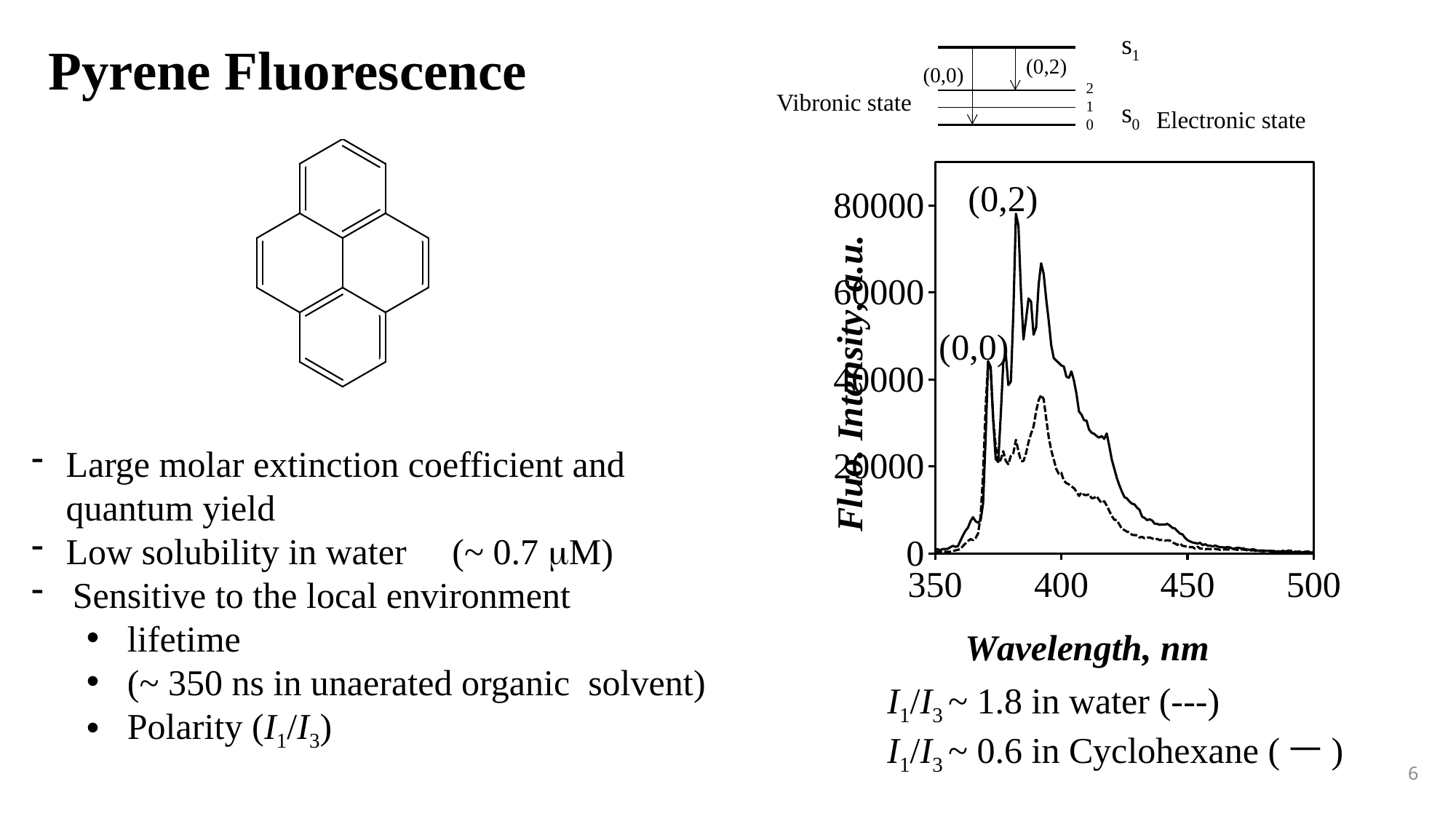
Do the intensities rise or fall as the wavelength increases from 400 nm to 500 nm? fall Is the maximum of the solid line (cyclohexane) greater or less than 60000? greater Which line reaches the higher peak intensity, the solid line or the dashed line? solid line What kind of chart is shown on the slide? line chart What is the label of the y axis of the chart? Fluo. Intensity, a.u. What is the lowest wavelength tick shown on the x axis? 350 What is the highest value shown on the y axis? 80000 How many spectra (lines) are plotted on the chart? 2 Is the intensity of the solid line at 450 nm greater or less than 20000? less Which vibronic band label is placed at the highest peak of the solid line? (0,2) What is the label of the x axis of the chart? Wavelength, nm